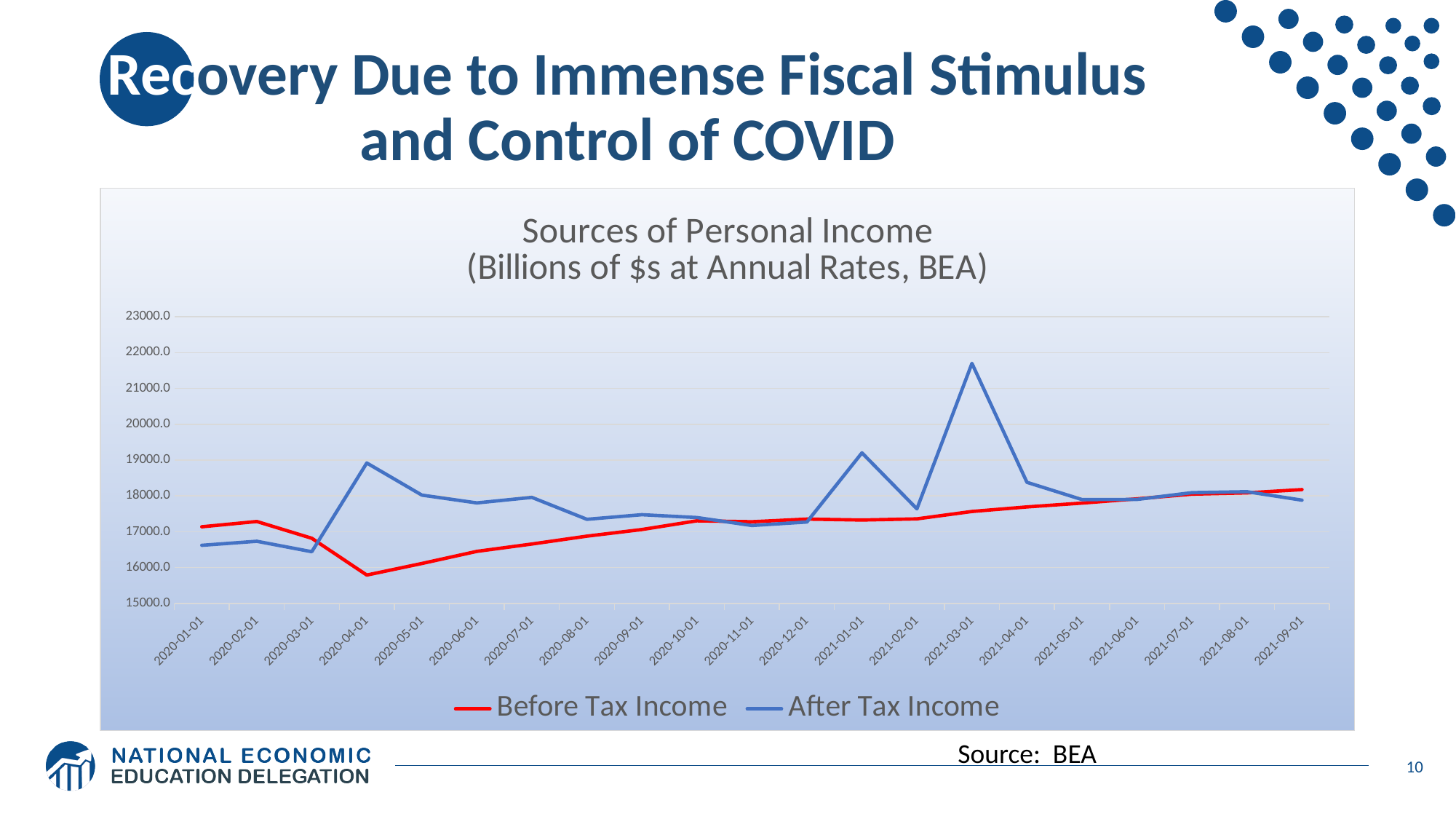
Is the value of After Tax Income at 2021-03-01 greater or less than 21000.0? greater At which date does After Tax Income reach its highest value? 2021-03-01 At which date does Before Tax Income reach its lowest value? 2020-04-01 How many dates are plotted along the x axis? 21 At 2020-04-01, which series has the higher value, Before Tax Income or After Tax Income? After Tax Income How many series does the legend list? 2 Is the value of After Tax Income at 2020-04-01 greater or less than 18000.0? greater Is the value of Before Tax Income at 2020-04-01 greater or less than 16000.0? less Does Before Tax Income generally rise or fall from 2020-04-01 to 2021-09-01? Rise What kind of chart is shown on the slide? Line chart At 2020-01-01, which series has the higher value, Before Tax Income or After Tax Income? Before Tax Income What colour is the line for After Tax Income? Blue